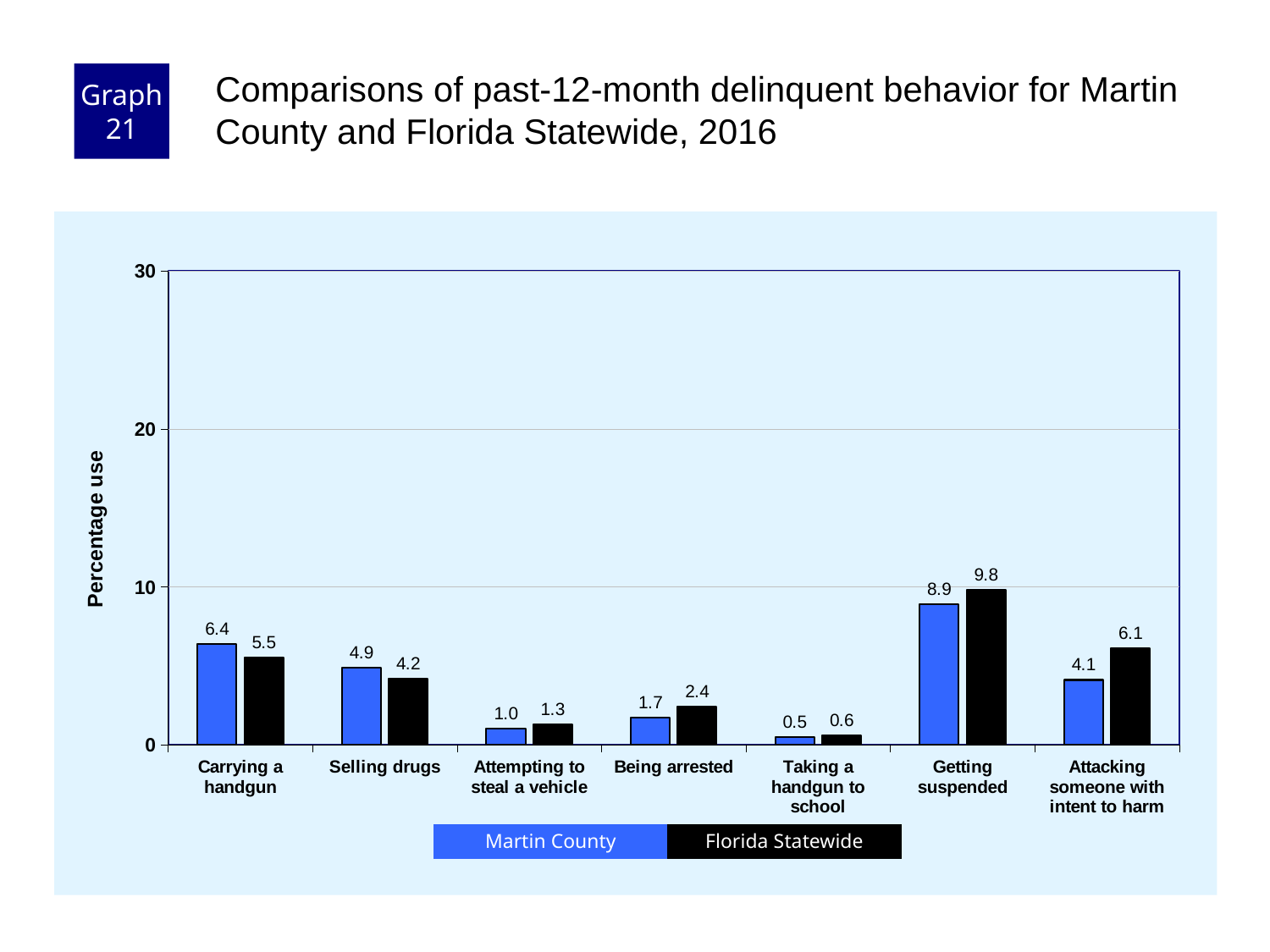
Which category has the highest Florida Statewide value? Getting suspended What is the Martin County value for Getting suspended? 8.9 What is the difference between the Florida Statewide and Martin County values for Attacking someone with intent to harm? 2.0 For Carrying a handgun, which is larger: the Martin County value or the Florida Statewide value? Martin County What is the label of the y axis? Percentage use How many categories are shown on the x axis? 7 What is the Florida Statewide value for Being arrested? 2.4 What is the Martin County value for Taking a handgun to school? 0.5 Which category has the lowest Martin County value? Taking a handgun to school How many series does the legend list? 2 What kind of chart is shown on the slide? bar chart Is the Florida Statewide value for Getting suspended greater or less than 10? less